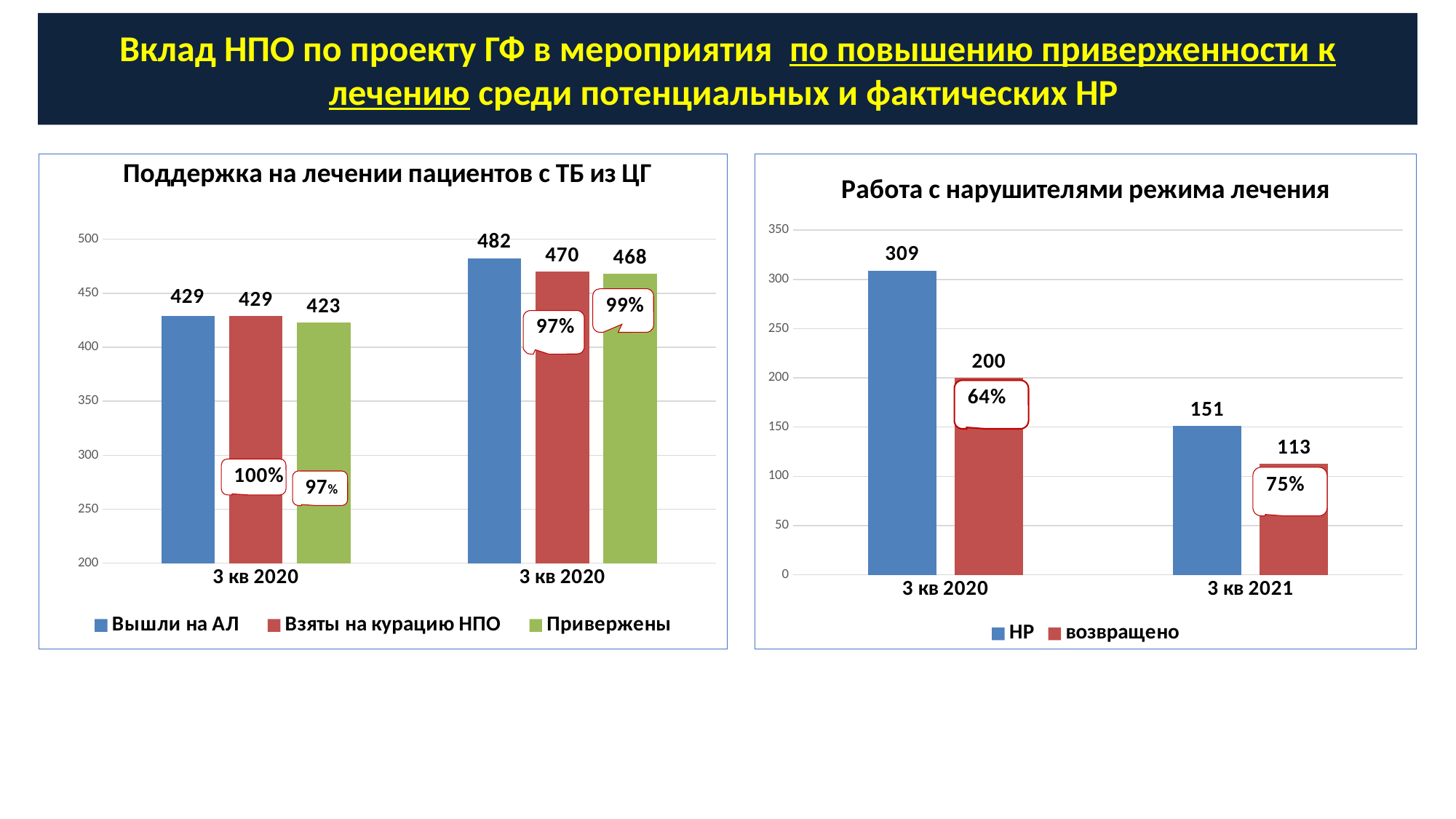
In the chart titled "Поддержка на лечении пациентов с ТБ из ЦГ", what is the value for Вышли на АЛ in the right-hand group of bars? 482 What type of chart is the chart titled "Поддержка на лечении пациентов с ТБ из ЦГ"? bar chart In the chart titled "Поддержка на лечении пациентов с ТБ из ЦГ", how many series does the legend list? 3 In the chart titled "Работа с нарушителями режима лечения", what is the difference between НР and возвращено in 3 кв 2020? 109 In the chart titled "Работа с нарушителями режима лечения", which bar is the highest? НР, 3 кв 2020 In the chart titled "Работа с нарушителями режима лечения", what is the value for НР in 3 кв 2020? 309 In the chart titled "Поддержка на лечении пациентов с ТБ из ЦГ", which is larger in the right-hand group: Взяты на курацию НПО or Привержены? Взяты на курацию НПО In the chart titled "Поддержка на лечении пациентов с ТБ из ЦГ", what is the difference between Вышли на АЛ and Привержены in the right-hand group of bars? 14 In the chart titled "Работа с нарушителями режима лечения", what is the value for возвращено in 3 кв 2021? 113 In the chart titled "Работа с нарушителями режима лечения", does the value for НР rise or fall from 3 кв 2020 to 3 кв 2021? fall In the chart titled "Работа с нарушителями режима лечения", how many series does the legend list? 2 In the chart titled "Поддержка на лечении пациентов с ТБ из ЦГ", what is the value for Привержены in the left-hand group of bars? 423